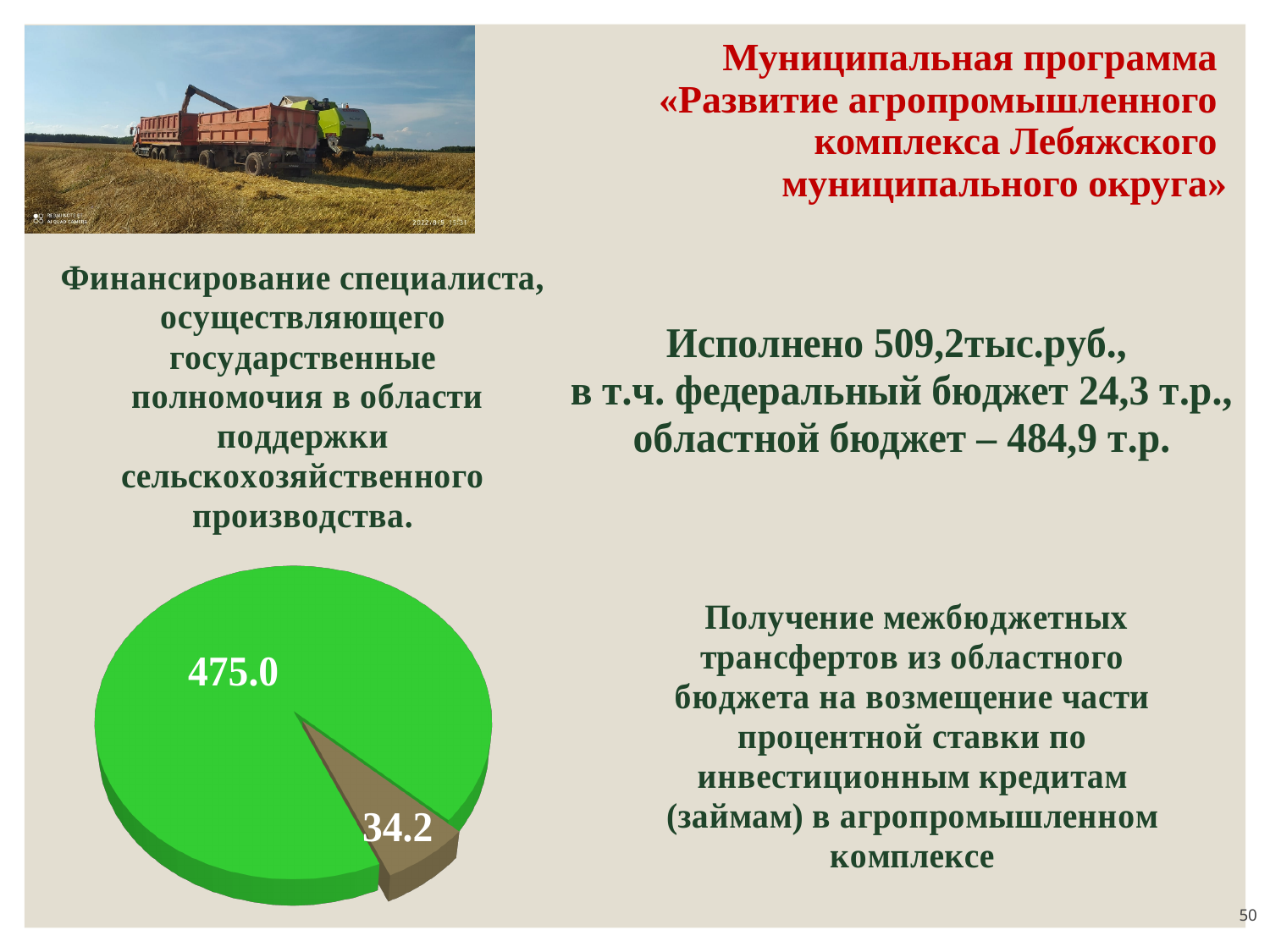
What is the value of the smallest slice in the pie chart? 34.2 What is the value of the largest slice in the pie chart? 475.0 What is the total of the two slice values in the pie chart? 509.2 Does the pie chart display a legend? No What colour is the largest slice of the pie chart? Green How many slices does the pie chart have? 2 What kind of chart is shown at the bottom left of the slide? Pie chart What share of the pie does the slice labelled 34.2 represent? 6.7% What value is labelled on the green slice of the pie chart? 475.0 What is the difference between the two slice values in the pie chart? 440.8 Which slice of the pie chart is larger, the green one or the brown one? The green one What value is labelled on the brown slice of the pie chart? 34.2